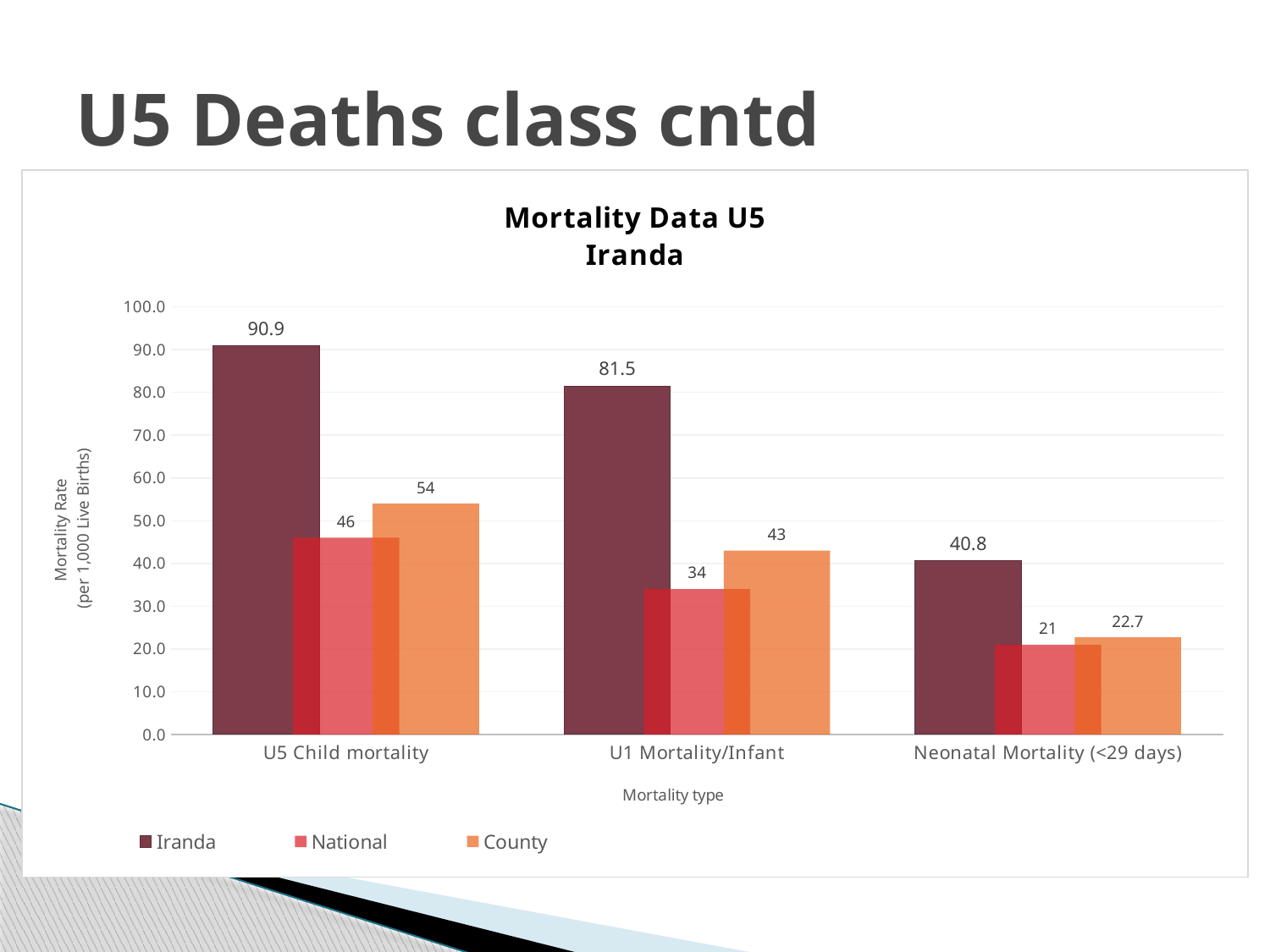
What is the difference between the Iranda and National values for U5 Child mortality? 44.9 What is the County value for Neonatal Mortality (<29 days)? 22.7 What is the difference between the County and National values for U1 Mortality/Infant? 9 What kind of chart is shown on the slide? Bar chart What is the Iranda value for U5 Child mortality? 90.9 How many mortality types are shown on the x axis? 3 How many series does the legend list? 3 Which mortality type has the highest Iranda value? U5 Child mortality What is the title of the chart? Mortality Data U5 Iranda Which mortality type has the lowest County value? Neonatal Mortality (<29 days) Which is larger for Neonatal Mortality (<29 days): the Iranda value or the County value? Iranda What is the National value for U1 Mortality/Infant? 34